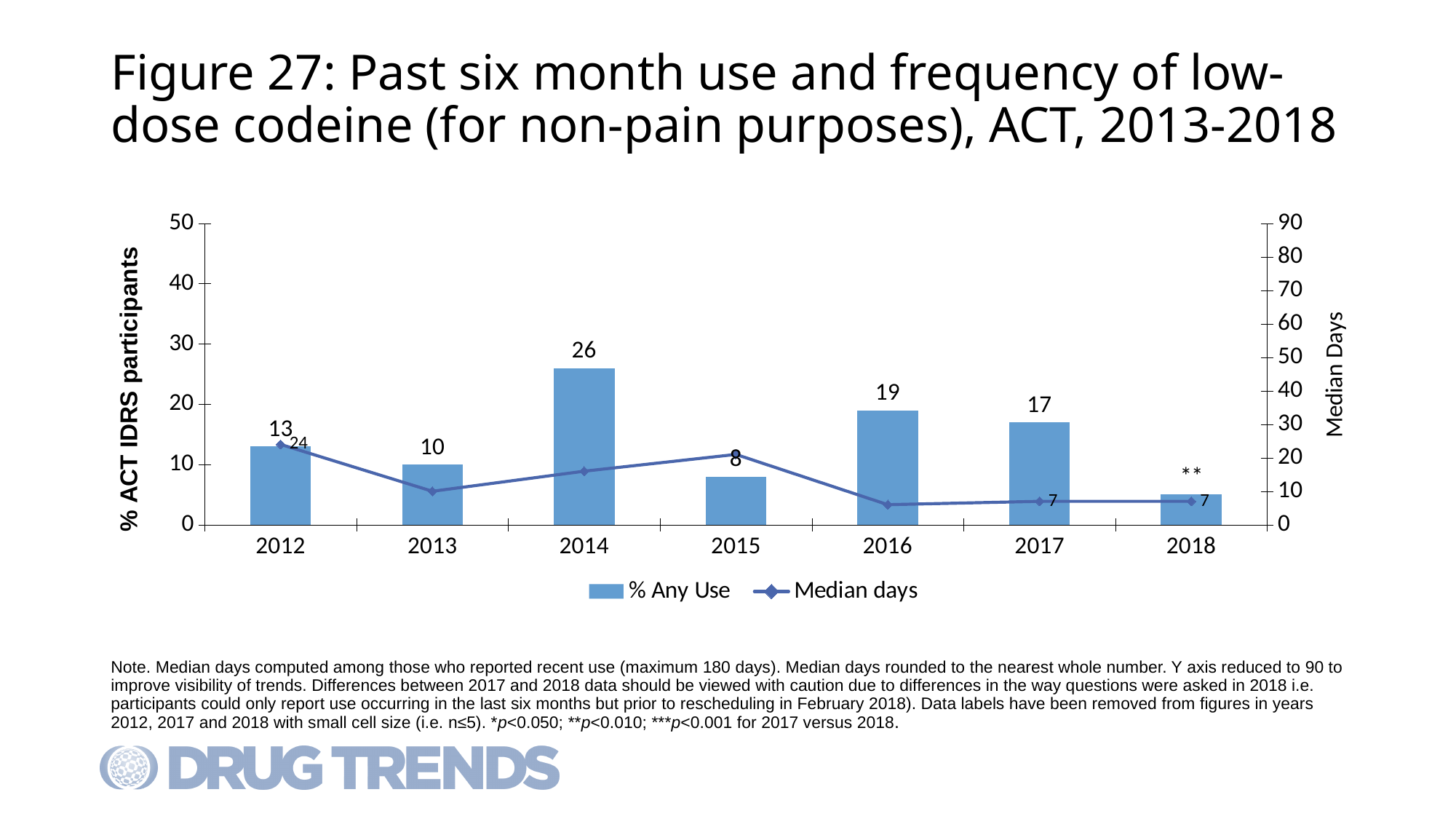
How many series does the legend list? 2 Is the Median days value for 2015 greater or less than 10? greater What is the difference between the % Any Use values for 2014 and 2016? 7 Which year has the lowest % Any Use bar? 2018 Which year has the larger % Any Use, 2016 or 2017? 2016 Which year has the highest % Any Use? 2014 Does the % Any Use value rise or fall from 2016 to 2018? fall What is the % Any Use value for 2016? 19 What is the % Any Use value for 2014? 26 Is the % Any Use value for 2018 greater or less than 10? less What is the Median days value for 2012? 24 How many years are shown on the x axis? 7